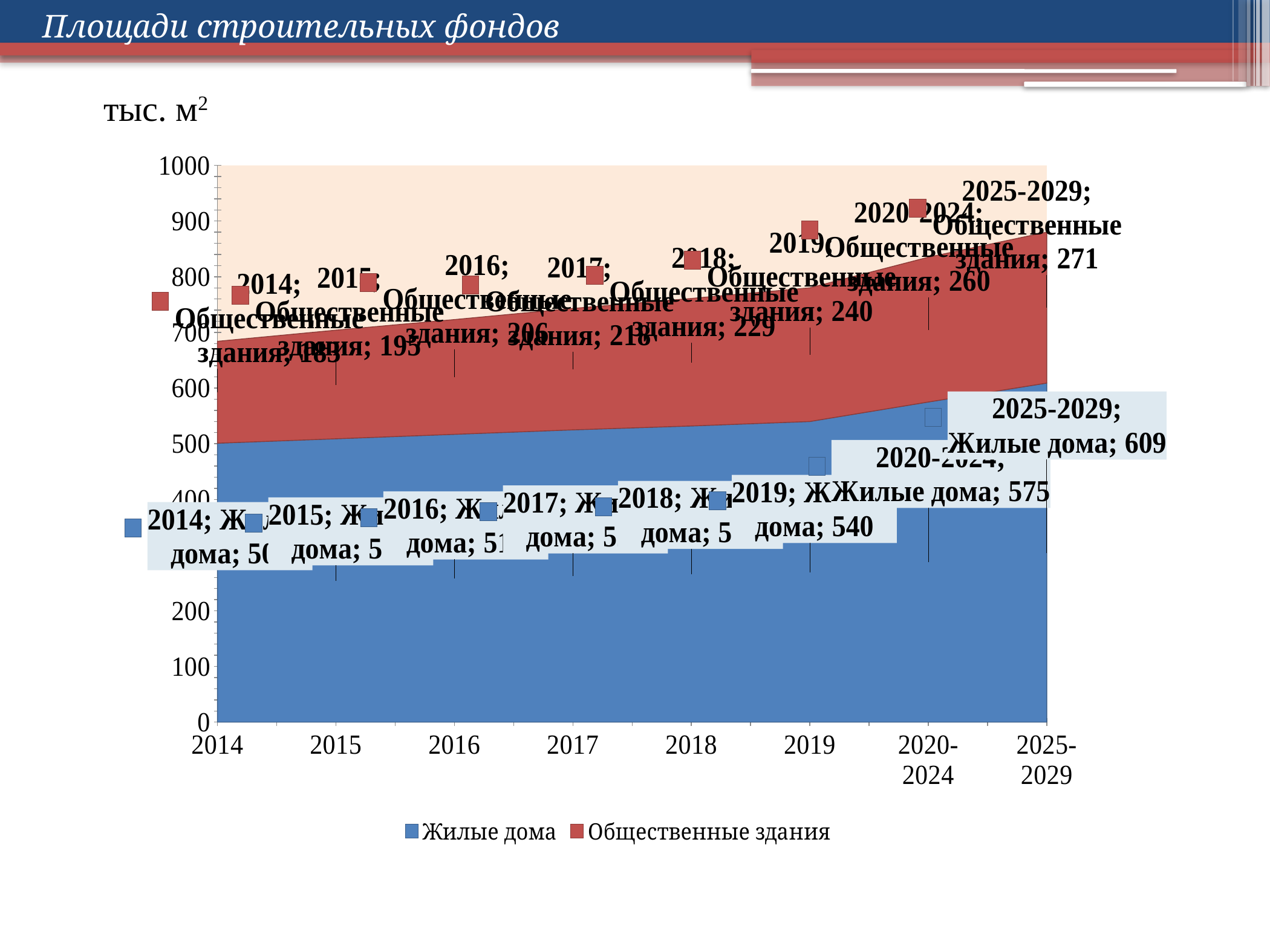
What is the value for Жилые дома in 2025-2029? 609 What kind of chart is shown on the slide? area chart How many categories are shown along the x axis? 8 What is the value for Общественные здания in 2019? 240 How many series does the legend list? 2 What is the value for Общественные здания in 2020-2024? 260 Which is larger in 2019, Жилые дома or Общественные здания? Жилые дома What is the difference between the Общественные здания values for 2025-2029 and 2015? 76 Do the Общественные здания values rise or fall from 2014 to 2025-2029? rise What is the value for Общественные здания in 2018? 229 What is the combined total of Жилые дома and Общественные здания for 2025-2029? 880 What is the difference between the Жилые дома values for 2025-2029 and 2020-2024? 34